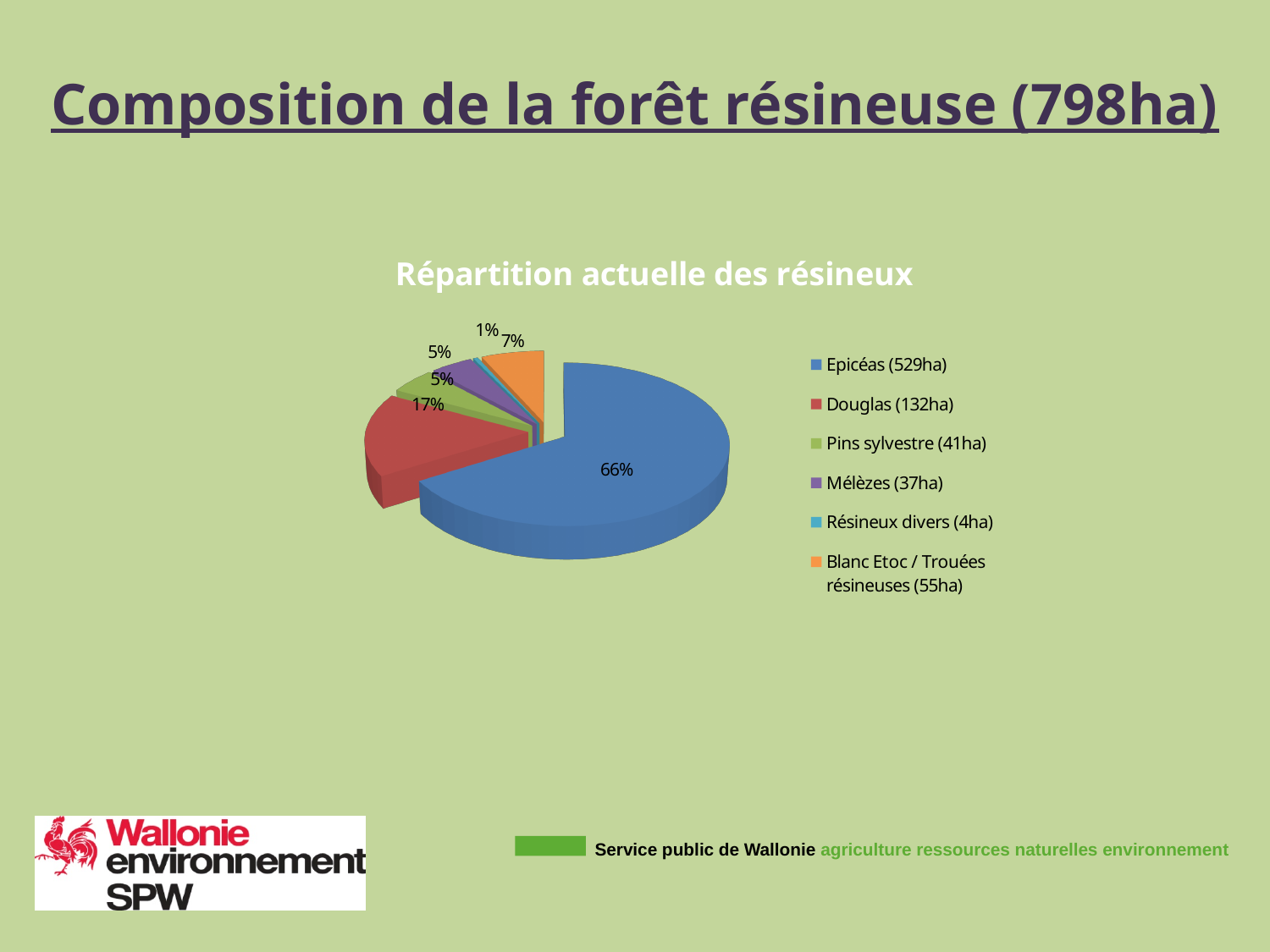
What is the title of the chart? Répartition actuelle des résineux What area in hectares is given for Mélèzes in the legend? 37ha How many slices does the pie chart have? 6 What share of the pie does Epicéas (529ha) represent? 66% Which category has the smallest slice of the pie? Résineux divers (4ha) Which category has the largest slice of the pie? Epicéas (529ha) What is the difference in percentage points between the Epicéas slice and the Douglas slice? 49 percentage points What share of the pie does Douglas (132ha) represent? 17% What share of the pie does Blanc Etoc / Trouées résineuses (55ha) represent? 7% What kind of chart is shown on the slide? Pie chart Which slice is larger: Douglas (132ha) or Blanc Etoc / Trouées résineuses (55ha)? Douglas (132ha)